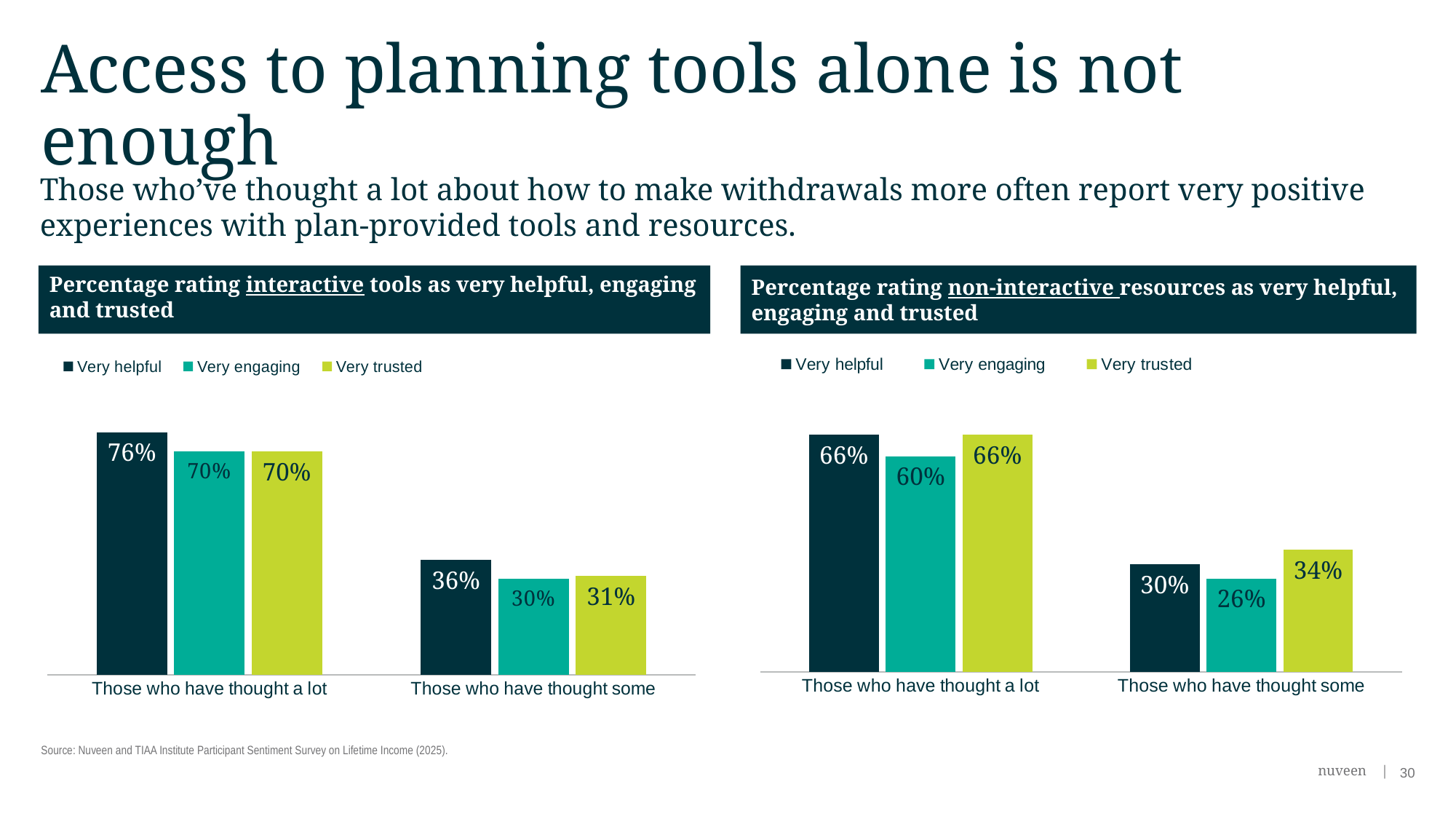
What kind of chart is the left chart (interactive tools)? Bar chart How many categories are shown on the x axis of the right chart (non-interactive resources)? 2 In the right chart (non-interactive resources), what is the difference between the 'Very trusted' values for those who have thought a lot and those who have thought some? 32 percentage points In the left chart (interactive tools), which series has the highest value for those who have thought a lot? Very helpful In the left chart (interactive tools), what percentage of those who have thought a lot rated the tools as very helpful? 76% In the right chart (non-interactive resources), which series has the lowest value for those who have thought some? Very engaging Which is larger: the 'Very helpful' value for those who have thought a lot in the left chart (interactive tools) or in the right chart (non-interactive resources)? Left chart (interactive tools), 76% In the right chart (non-interactive resources), what is the 'Very engaging' value for those who have thought a lot? 60% In the right chart (non-interactive resources), what percentage of those who have thought some rated the resources as very trusted? 34% How many series does the legend of the left chart (interactive tools) list? 3 In the left chart (interactive tools), what is the 'Very engaging' value for those who have thought some? 30% In the left chart (interactive tools), what is the difference between the 'Very helpful' values for those who have thought a lot and those who have thought some? 40 percentage points